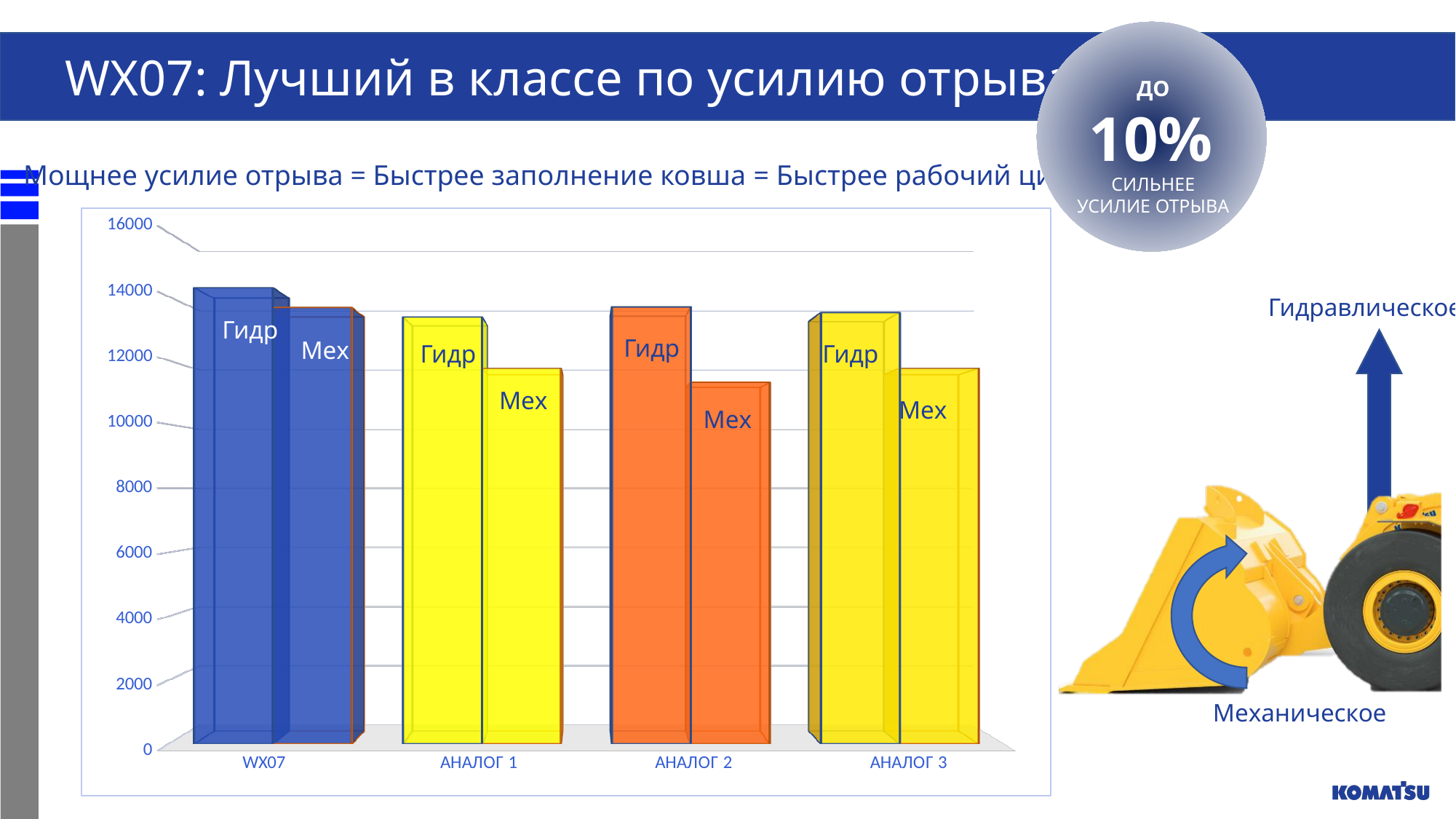
What is the highest tick value shown on the y axis of the chart? 16000 Which is larger: the Мех value for WX07 or the Мех value for АНАЛОГ 3? WX07 Which is larger: the Гидр value for WX07 or the Гидр value for АНАЛОГ 1? WX07 Is the Гидр value for WX07 greater or less than 12000? greater For АНАЛОГ 2, which bar is taller: Гидр or Мех? Гидр Is the Мех value for WX07 greater or less than 12000? greater Which category has the tallest bar in the chart? WX07 Is the Гидр value for АНАЛОГ 1 greater or less than 14000? less What kind of chart is shown on the slide? bar chart How many categories are shown on the x axis of the chart? 4 What are the two bar labels shown within each category of the chart? Гидр and Мех